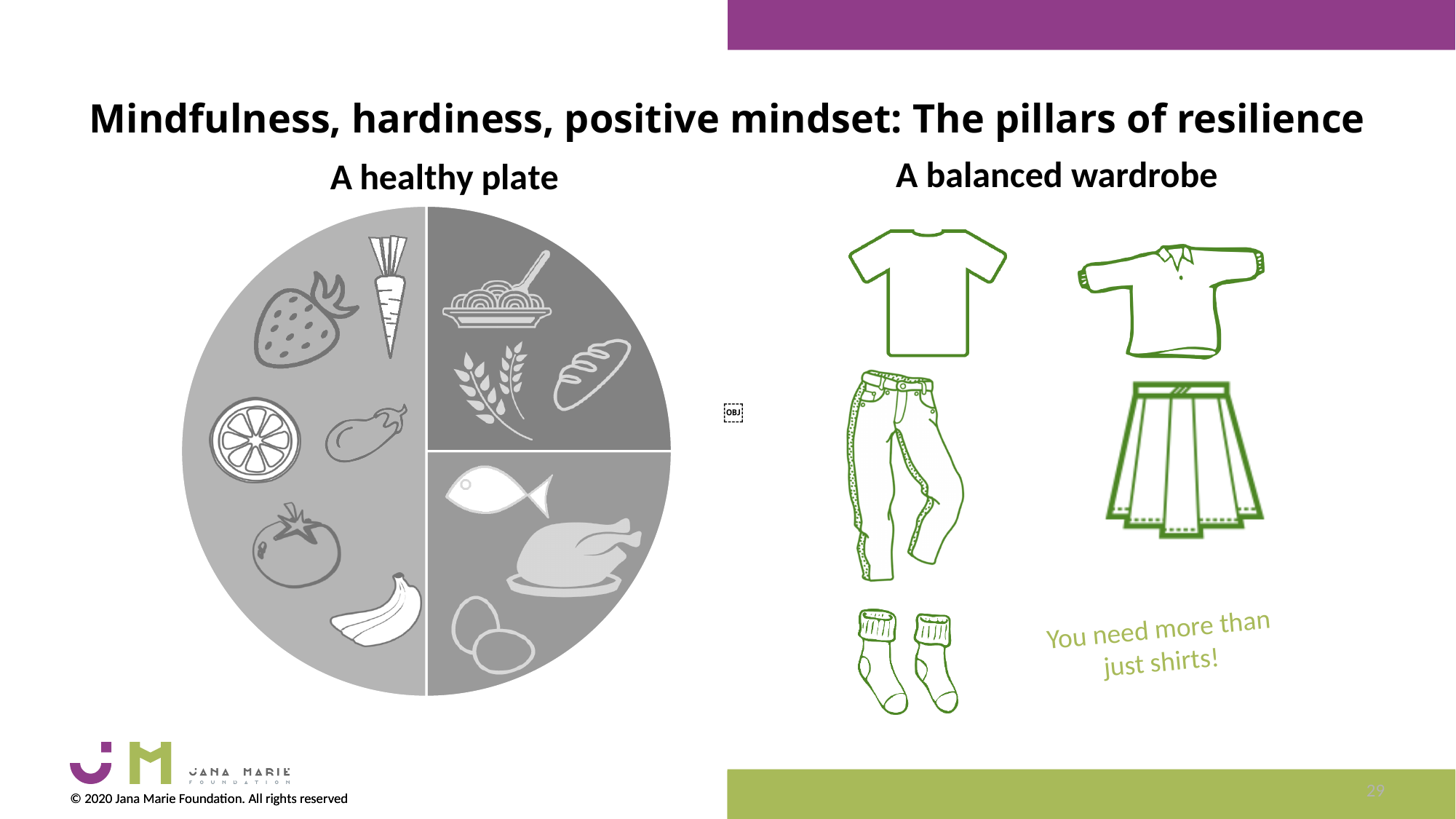
What is the title above the circular plate chart on the left of the slide? A healthy plate In the 'A healthy plate' chart, which section is the largest? the left section with fruits and vegetables What kind of chart is the 'A healthy plate' diagram on the left of the slide? pie chart In the 'A healthy plate' chart, is the section with fish, chicken and eggs larger or smaller than the section with fruits and vegetables? smaller In the 'A healthy plate' chart, is the fruits and vegetables section larger or smaller than the grains section (pasta, wheat, bread)? larger What is the title above the clothing illustration on the right of the slide? A balanced wardrobe How many sections is the 'A healthy plate' circle divided into? 3